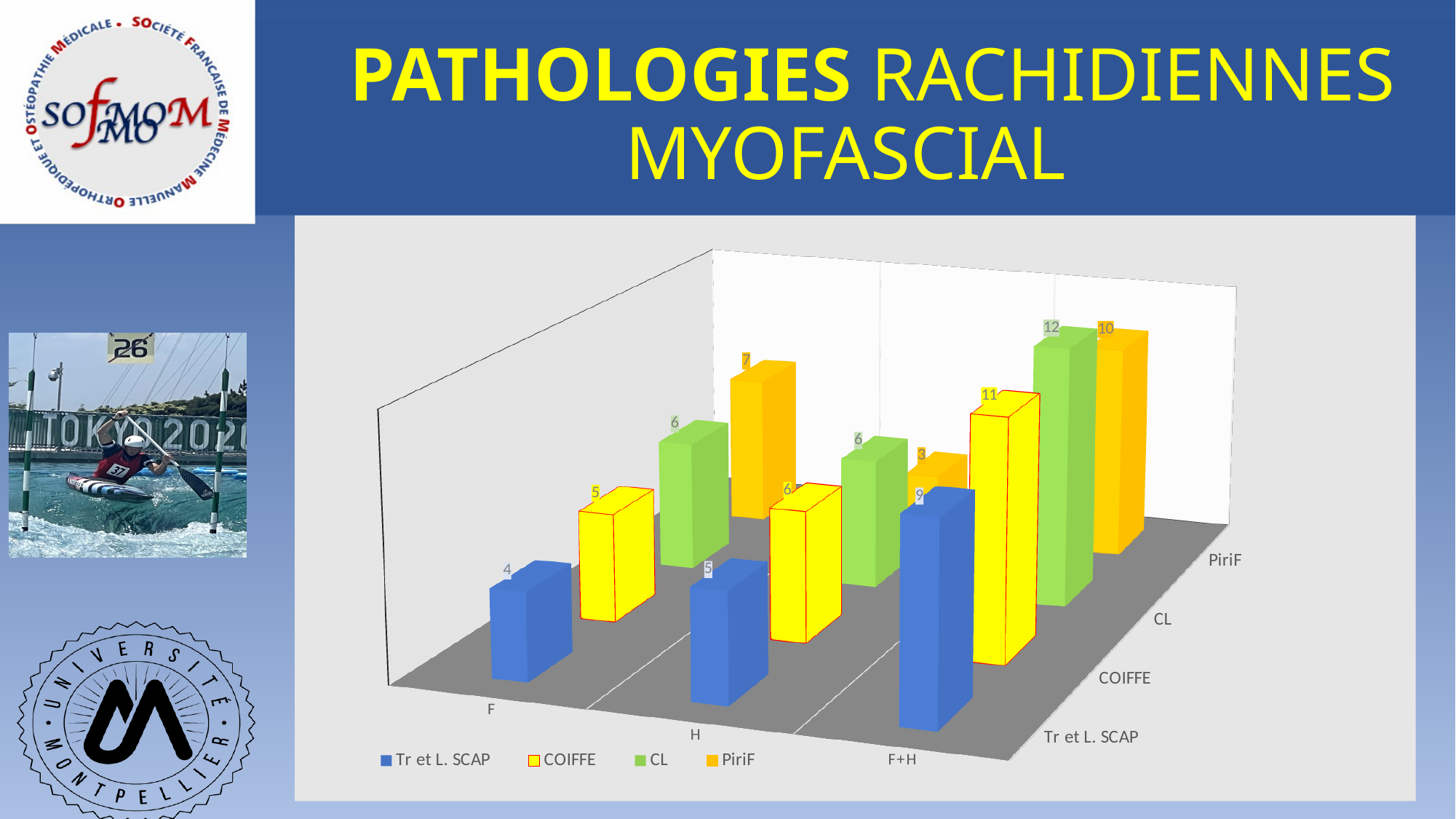
Which series has the highest value in the F+H category? CL What is the value for COIFFE in the F+H category? 11 What kind of chart is shown on the slide? 3D bar chart How many series does the legend list? 4 What is the difference between the PiriF values for F+H and F? 3 How many categories are shown on the x axis? 3 Which is larger, the COIFFE value for F or the COIFFE value for H? COIFFE value for H What colour are the COIFFE bars? Yellow What is the value for Tr et L. SCAP in the F category? 4 Which series has the lowest value in the H category? PiriF What is the value for CL in the F+H category? 12 What is the value for PiriF in the H category? 3